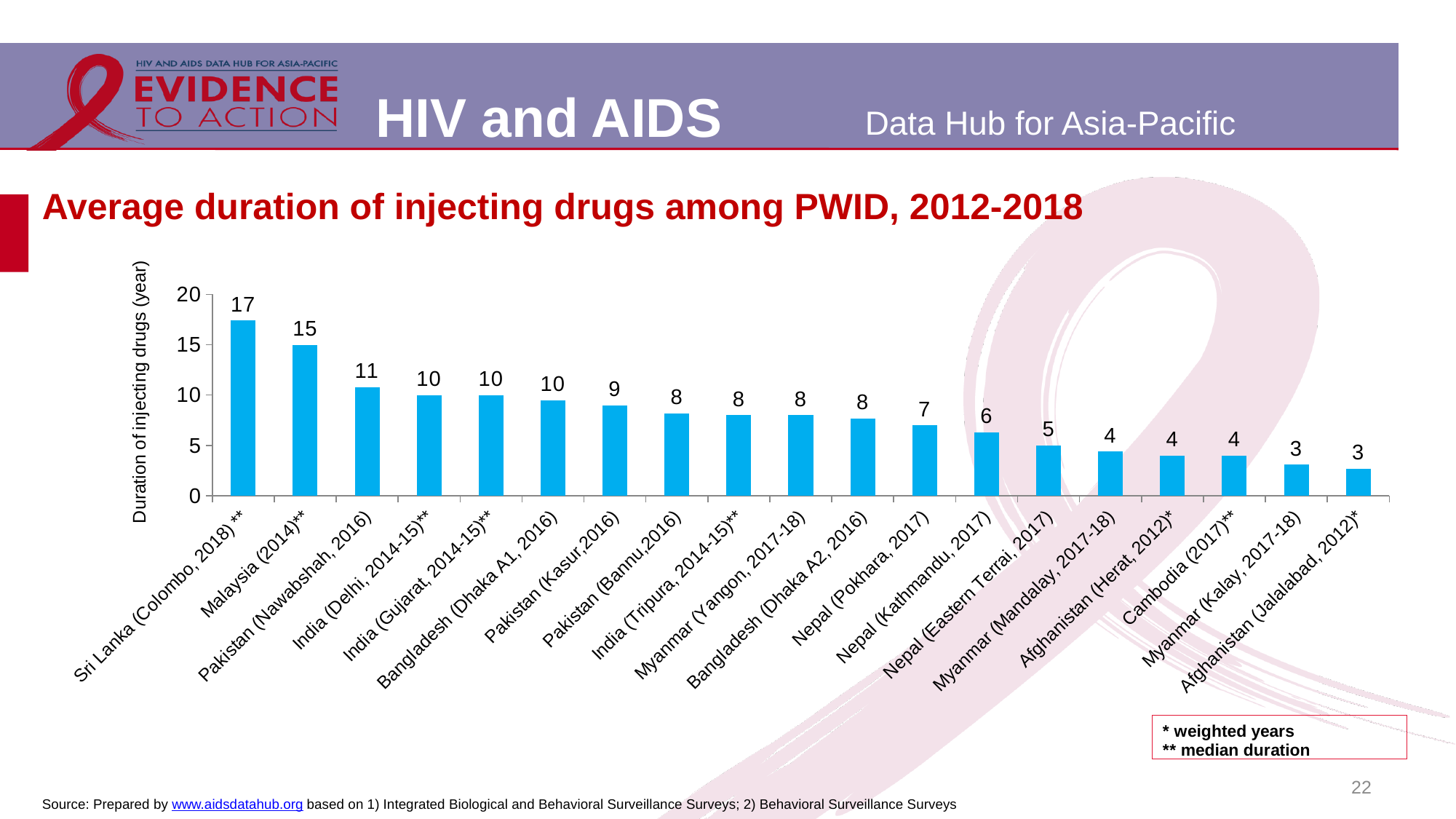
What is the value shown for Nepal (Kathmandu, 2017)? 6 What is the average duration of injecting drugs for Sri Lanka (Colombo, 2018)? 17 What is the value shown for Cambodia (2017)? 4 What kind of chart is shown on the slide? Bar chart What is the difference between the values for Sri Lanka (Colombo, 2018) and Malaysia (2014)? 2 Which is larger, the value for Malaysia (2014) or the value for Pakistan (Nawabshah, 2016)? Malaysia (2014) Which category has the highest average duration of injecting drugs? Sri Lanka (Colombo, 2018) What is the difference between the values for Pakistan (Nawabshah, 2016) and Nepal (Pokhara, 2017)? 4 Do the values rise or fall from left to right along the x axis? Fall Is the value for Nepal (Eastern Terrai, 2017) greater or less than 10? less How many categories are plotted in the chart? 19 What is the value shown for Pakistan (Nawabshah, 2016)? 11